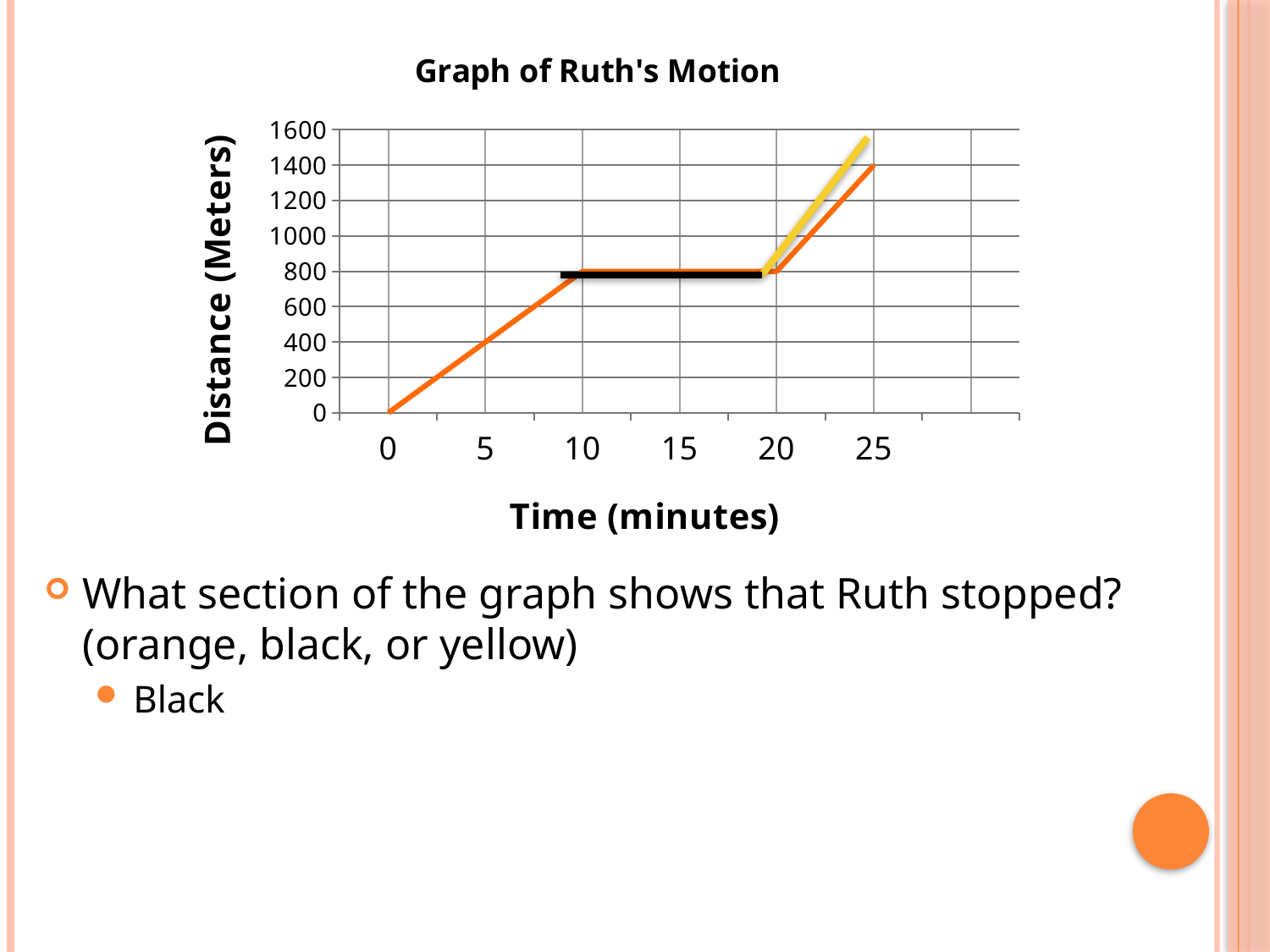
Which coloured section of the graph is flat, showing no change in distance? black Is the distance at 25 minutes larger or smaller than the distance at 10 minutes? larger What is the distance at time 0 minutes? 0 At what distance does the flat (black) section of the graph sit? 800 Is the distance at 5 minutes greater or less than 600? less Is the distance at 15 minutes greater or less than 1000? less Is the distance at 5 minutes greater or less than 200? greater What is the highest value shown on the Distance (Meters) axis? 1600 Does the distance rise or fall as time increases from 0 to 25 minutes? rise What kind of chart is shown on the slide? line chart What is the title of the chart? Graph of Ruth's Motion